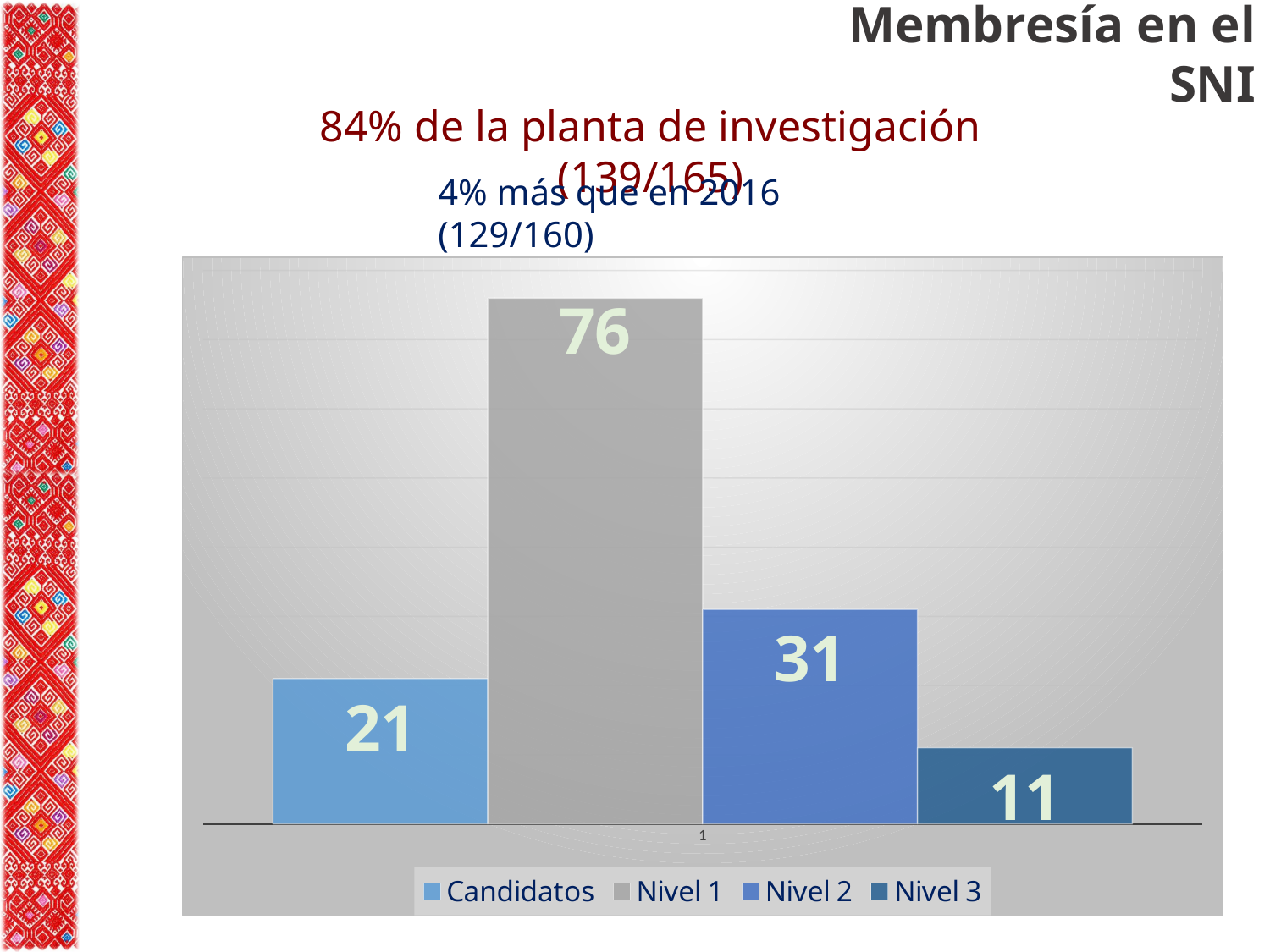
What is the value for Nivel 2? 31 Which is larger, the value for Candidatos or the value for Nivel 2? Nivel 2 Which series has the highest value? Nivel 1 What colour is the bar for Nivel 1? Grey What kind of chart is shown on the slide? Bar chart What is the value for Nivel 1? 76 What is the value for Candidatos? 21 What is the total of all four bars shown in the chart? 139 What is the value for Nivel 3? 11 How many series does the legend list? 4 Which series has the lowest value? Nivel 3 What is the difference between the values for Nivel 1 and Nivel 2? 45